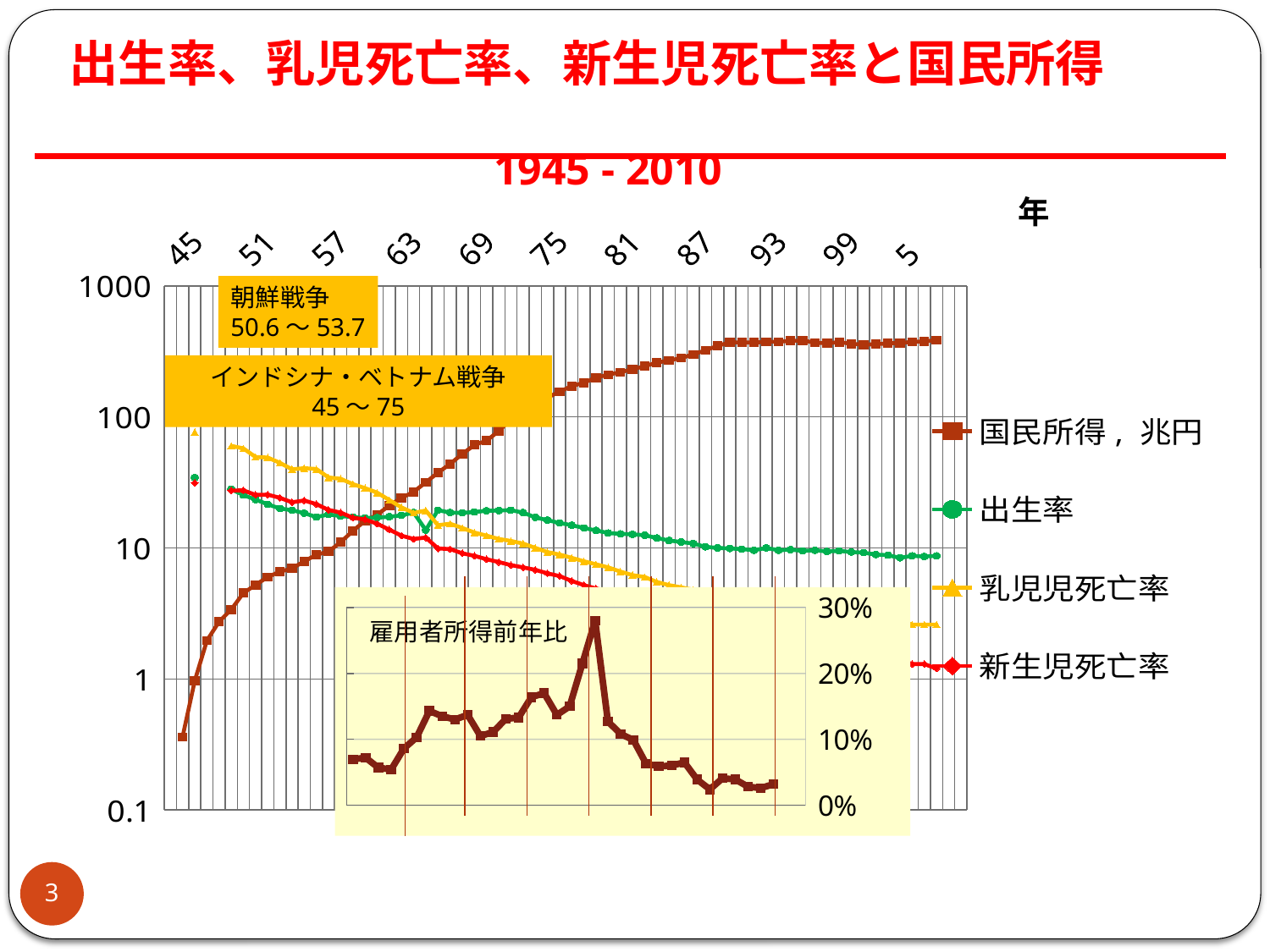
In the main chart, which is larger in 1987: 出生率 or 乳児児死亡率? 出生率 In the main chart, which is larger in 1951: 国民所得 or 出生率? 出生率 What are the four series listed in the legend of the main chart? 国民所得，兆円, 出生率, 乳児児死亡率, 新生児死亡率 In the main chart, does 国民所得 rise or fall from 1945 to 2010? rise How many series does the legend of the main chart list? 4 What is the title of the inset chart in the lower part of the slide? 雇用者所得前年比 What kind of chart is the main chart on the slide? line chart In the main chart, is the value of 国民所得 in 2005 greater or less than 100? greater In the main chart, does 出生率 rise or fall overall from 1947 to 2010? fall In the main chart, does 乳児児死亡率 rise or fall over the years shown? fall In the main chart, is the value of 出生率 in 2005 greater or less than 10? less